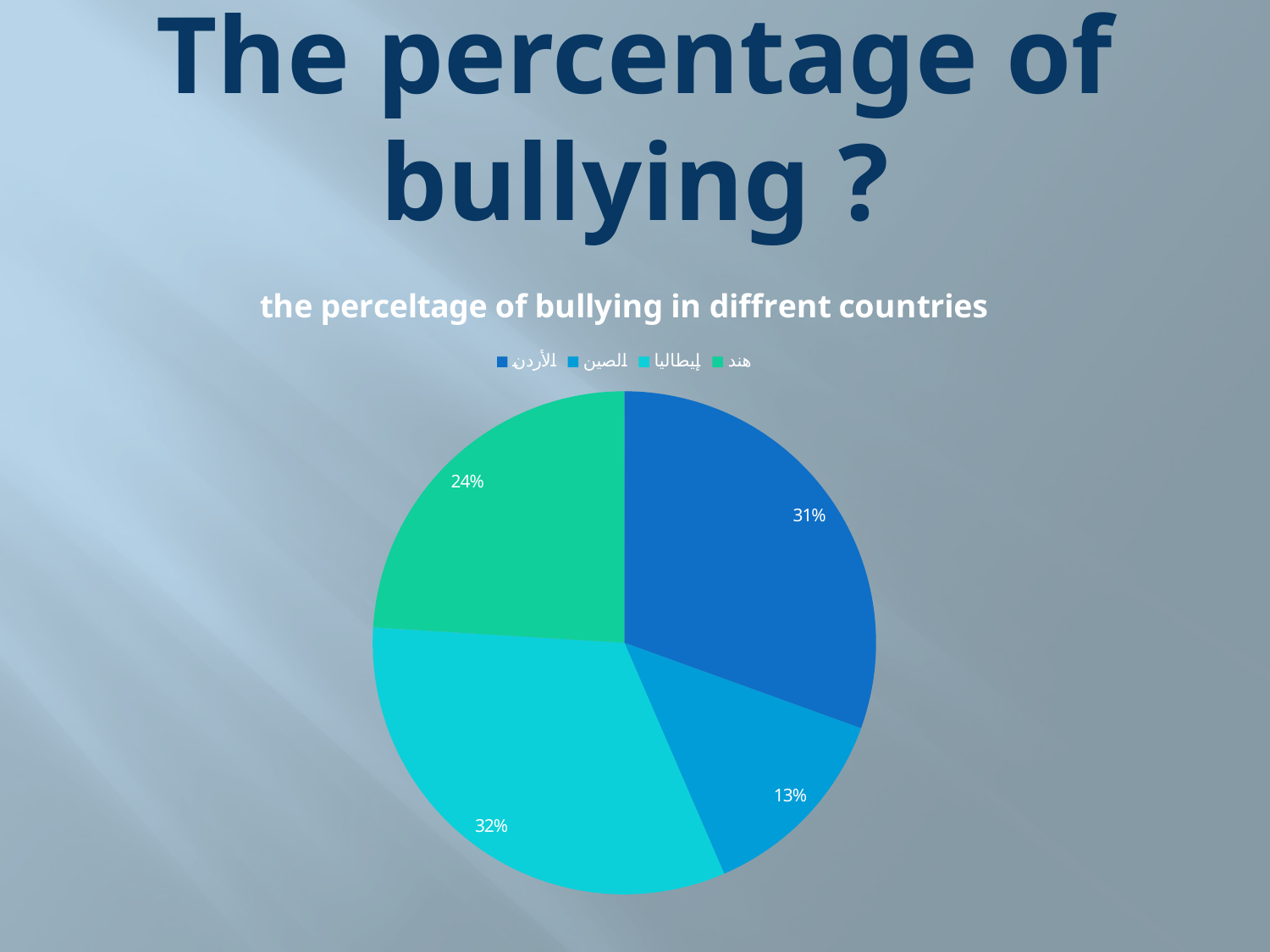
What kind of chart is shown on the slide? pie chart What is the largest percentage shown on the pie chart? 32% What percentage is shown for the cyan slice (إيطاليا)? 32% What percentage is shown for the dark blue slice (الأردن)? 31% What is the smallest percentage shown on the pie chart? 13% What is the difference between the largest slice (32%) and the smallest slice (13%)? 19% Which is larger, the slice labelled 31% or the slice labelled 24%? 31% What is the title of the chart? the perceltage of bullying in diffrent countries What percentage is shown for the green slice (هند)? 24% How many slices does the pie chart have? 4 What is the difference between the 31% slice and the 13% slice? 18% How many entries does the legend list? 4